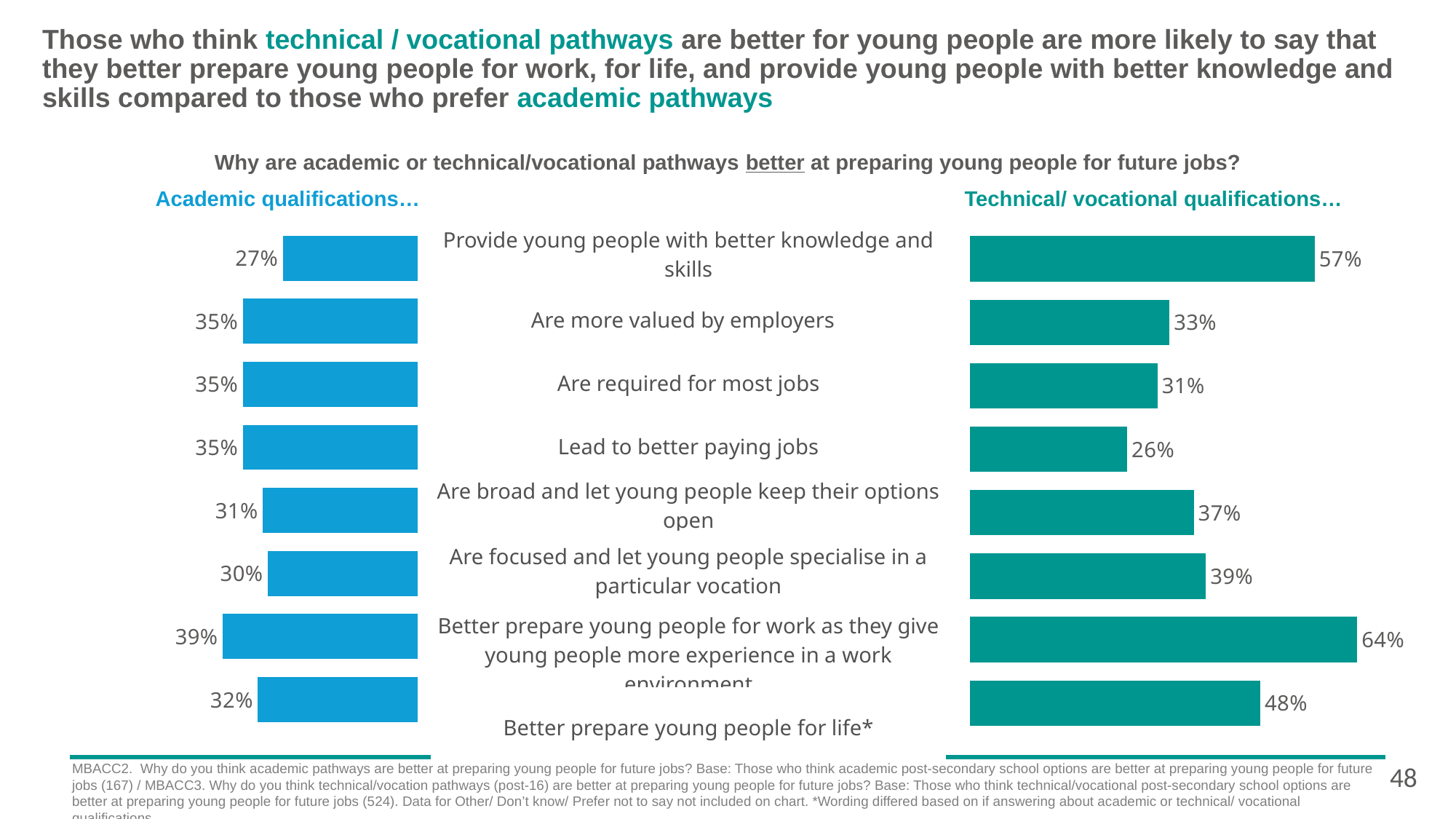
What colour are the bars in the 'Academic qualifications…' chart? Blue In the 'Academic qualifications…' chart, which category has the highest value? Better prepare young people for work as they give young people more experience in a work environment In the 'Technical/ vocational qualifications…' chart, which category has the lowest value? Lead to better paying jobs In the 'Technical/ vocational qualifications…' chart, what percentage is shown for 'Better prepare young people for life*'? 48% In the 'Academic qualifications…' chart, which category has the lowest value? Provide young people with better knowledge and skills In the 'Academic qualifications…' chart, what percentage is shown for 'Provide young people with better knowledge and skills'? 27% How many categories are shown in the 'Academic qualifications…' chart? 8 For 'Are more valued by employers', which is larger: the 'Academic qualifications…' value or the 'Technical/ vocational qualifications…' value? Academic qualifications… In the 'Technical/ vocational qualifications…' chart, what percentage is shown for 'Are broad and let young people keep their options open'? 37% What type of chart is the 'Technical/ vocational qualifications…' chart? Bar chart What is the difference between the 'Technical/ vocational qualifications…' value and the 'Academic qualifications…' value for 'Provide young people with better knowledge and skills'? 30 percentage points In the 'Technical/ vocational qualifications…' chart, which category has the highest value? Better prepare young people for work as they give young people more experience in a work environment